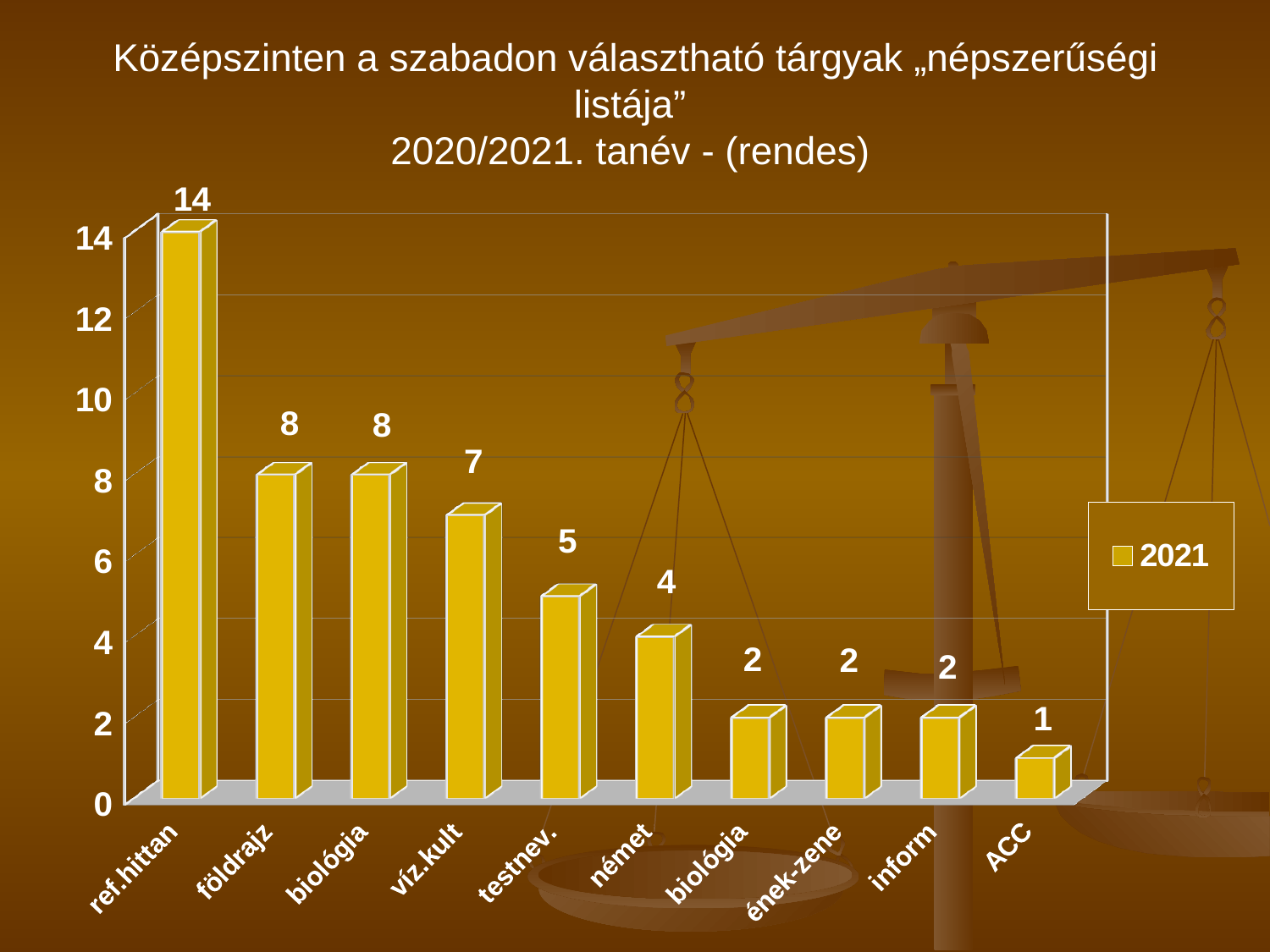
What is the value for német? 4 What is the value for testnev.? 5 What is the value for ref.hittan? 14 What is the value for ACC? 1 Which category has the highest value? ref.hittan Which category has the lowest value? ACC How many categories are shown on the x axis? 10 What kind of chart is shown on the slide? bar chart What is the value for víz.kult? 7 What is the difference between the values for ref.hittan and földrajz? 6 How many series does the legend list? 1 Which is larger, the value for testnev. or the value for német? testnev.